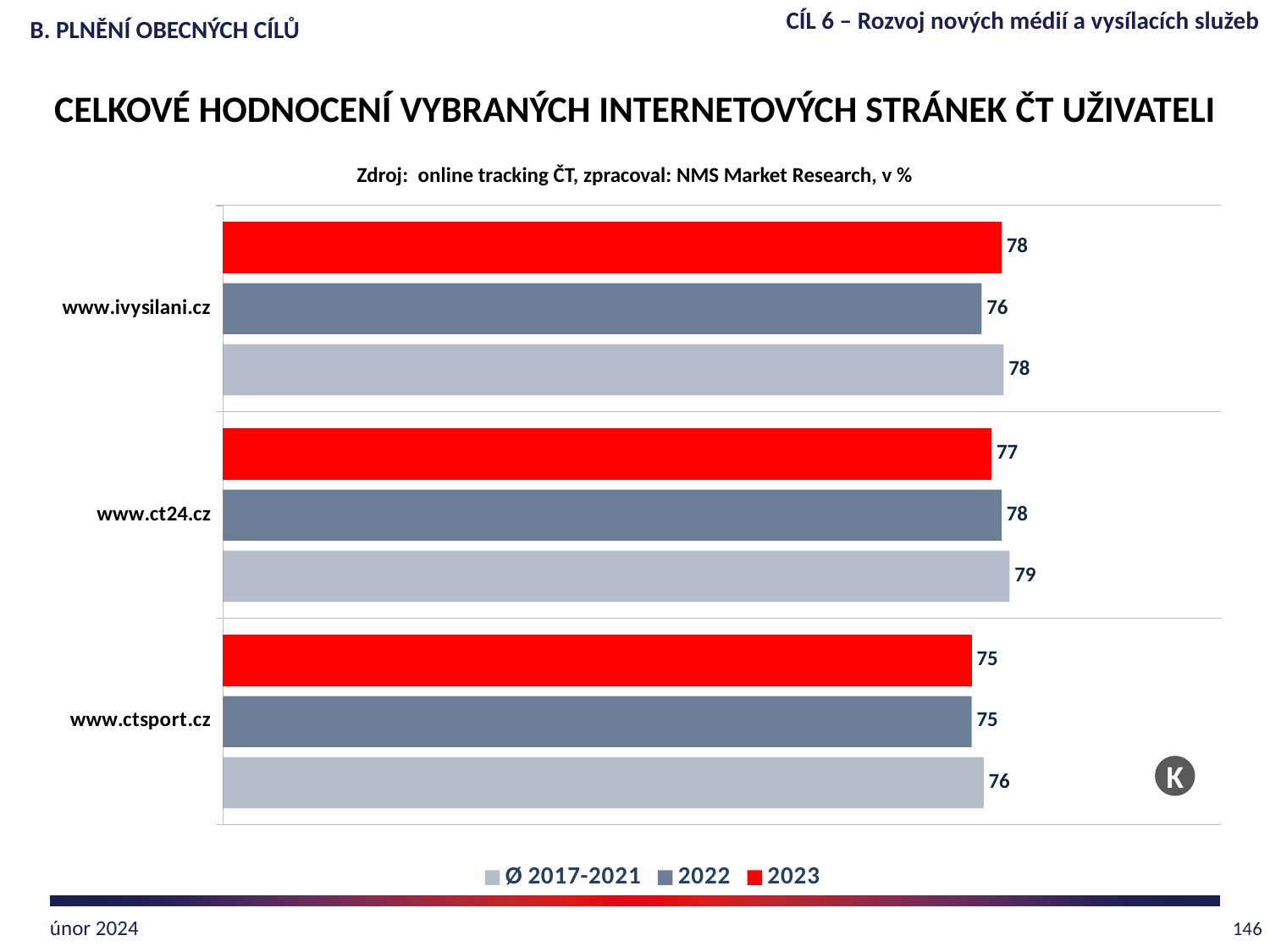
Which colour represents the 2023 series in the chart? red Which website has the highest Ø 2017-2021 value? www.ct24.cz What is the 2022 value for www.ct24.cz? 78 For www.ct24.cz, which is larger: the Ø 2017-2021 value or the 2023 value? Ø 2017-2021 What is the Ø 2017-2021 value for www.ctsport.cz? 76 How many series does the legend list? 3 What is the difference between the 2023 value and the 2022 value for www.ivysilani.cz? 2 What is the 2023 value for www.ivysilani.cz? 78 What is the 2023 value for www.ctsport.cz? 75 How many websites are shown in the chart? 3 What kind of chart is shown on the slide? bar chart Which website has the lowest 2023 value? www.ctsport.cz